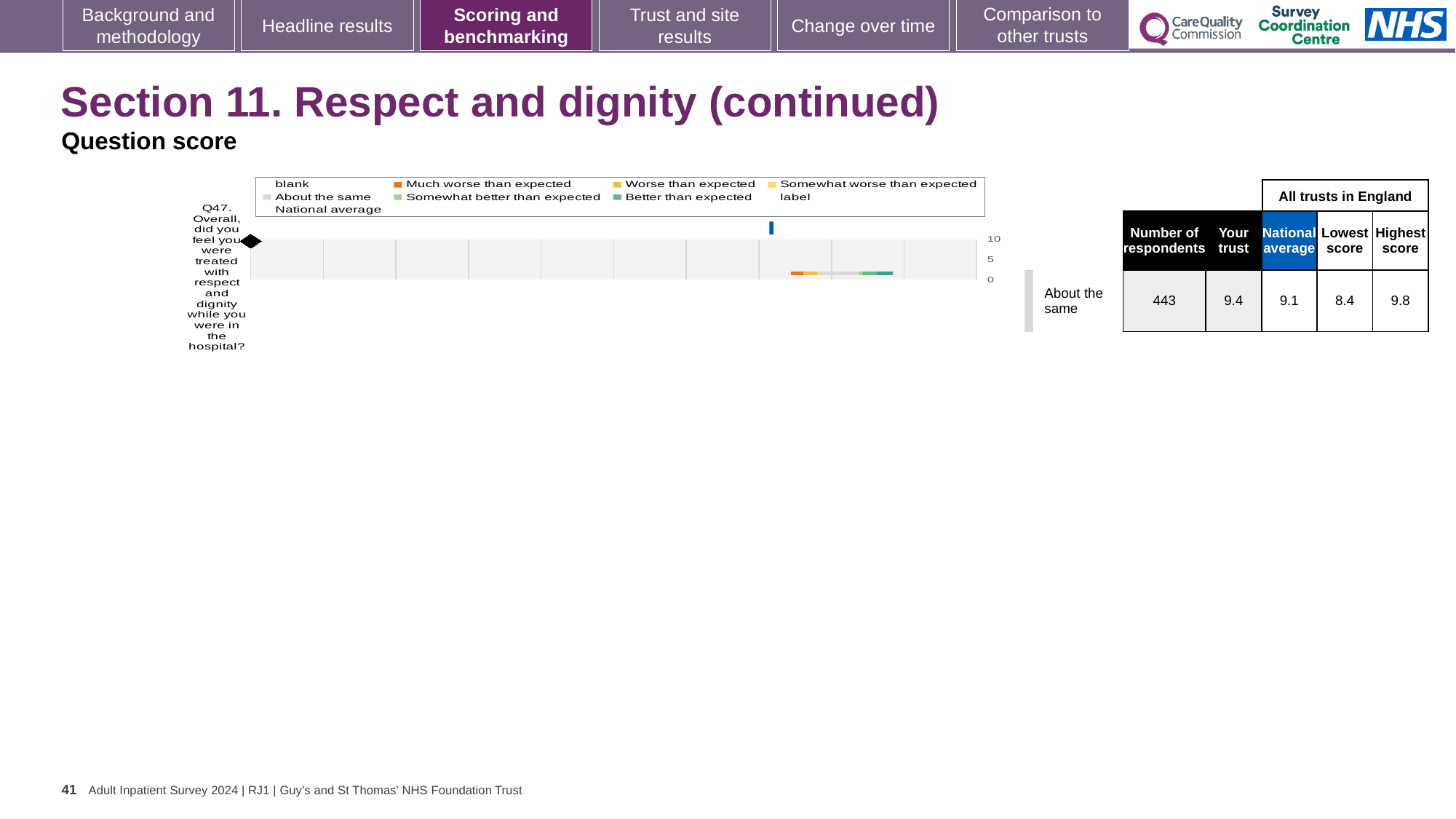
What is the highest score among all trusts in England for Q47? 9.8 What is the maximum value shown on the chart's score axis? 10 Which survey question is shown on the chart? Q47. Overall, did you feel you were treated with respect and dignity while you were in the hospital? What is the 'Your trust' score for Q47? 9.4 By how much does the trust's score for Q47 exceed the national average? 0.3 What is the national average score for Q47? 9.1 What is the lowest score among all trusts in England for Q47? 8.4 Which is higher for Q47, the trust's score or the national average? Your trust How many respondents answered Q47? 443 What is the difference between the highest and lowest scores across all trusts in England for Q47? 1.4 What benchmarking category is the trust placed in for Q47? About the same